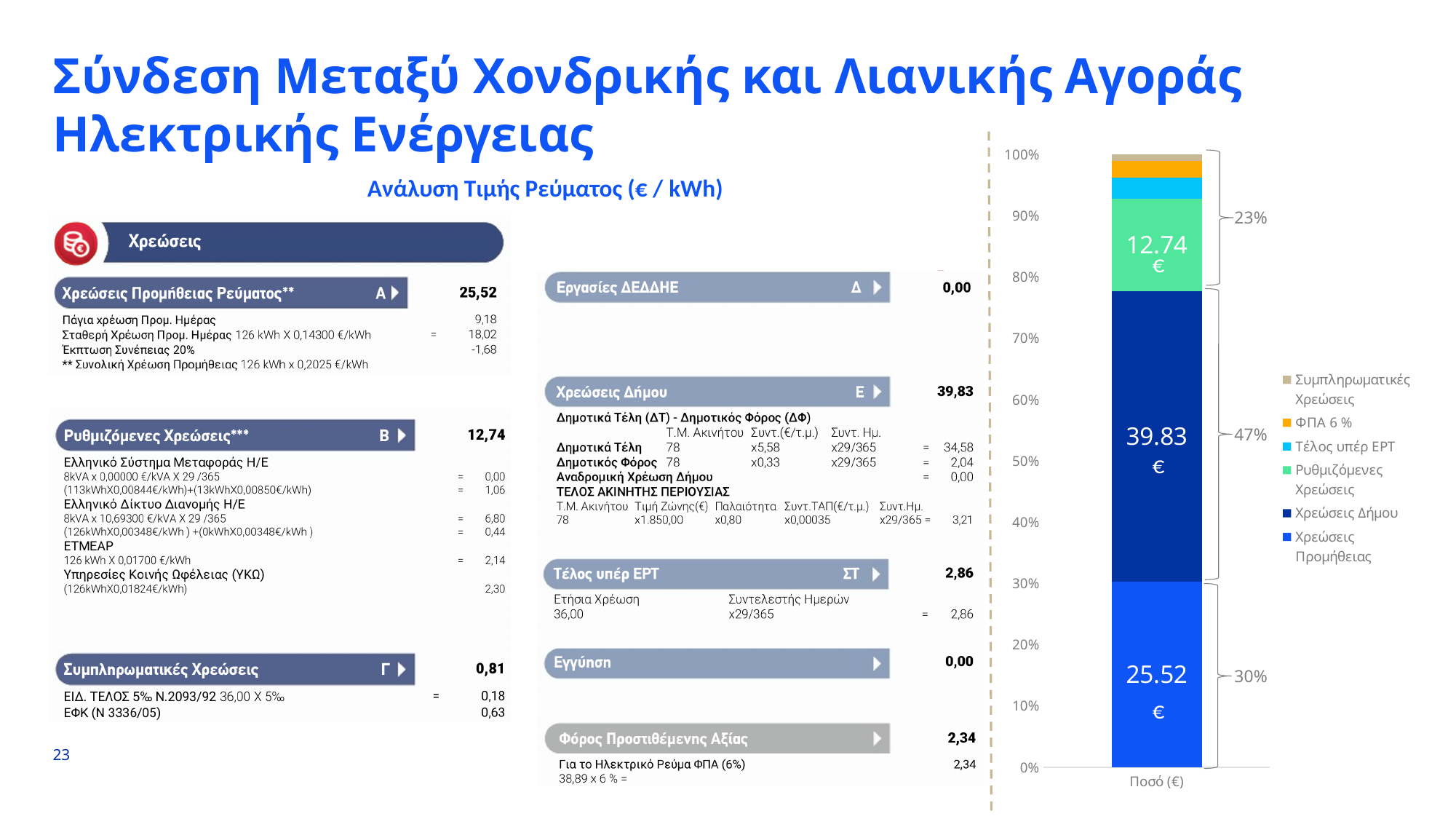
What is the difference between the labelled values for Χρεώσεις Δήμου and Χρεώσεις Προμήθειας? 14.31 € What kind of chart is shown on the right of the slide? Stacked bar chart How many bars (categories) are plotted in the chart on the right? 1 In the stacked bar chart, what is the value labelled for Χρεώσεις Προμήθειας? 25.52 € In the stacked bar chart, what is the value labelled for Ρυθμιζόμενες Χρεώσεις? 12.74 € In the stacked bar chart, what is the value labelled for Χρεώσεις Δήμου? 39.83 € What is the category label on the x axis of the stacked bar chart? Ποσό (€) What percentage is annotated next to the Χρεώσεις Δήμου segment of the stacked bar? 47% Which series has the largest segment in the stacked bar? Χρεώσεις Δήμου What is the difference between the labelled values for Χρεώσεις Προμήθειας and Ρυθμιζόμενες Χρεώσεις? 12.78 € How many series does the legend of the stacked bar chart list? 6 Which is larger in the stacked bar: Χρεώσεις Δήμου or Χρεώσεις Προμήθειας? Χρεώσεις Δήμου